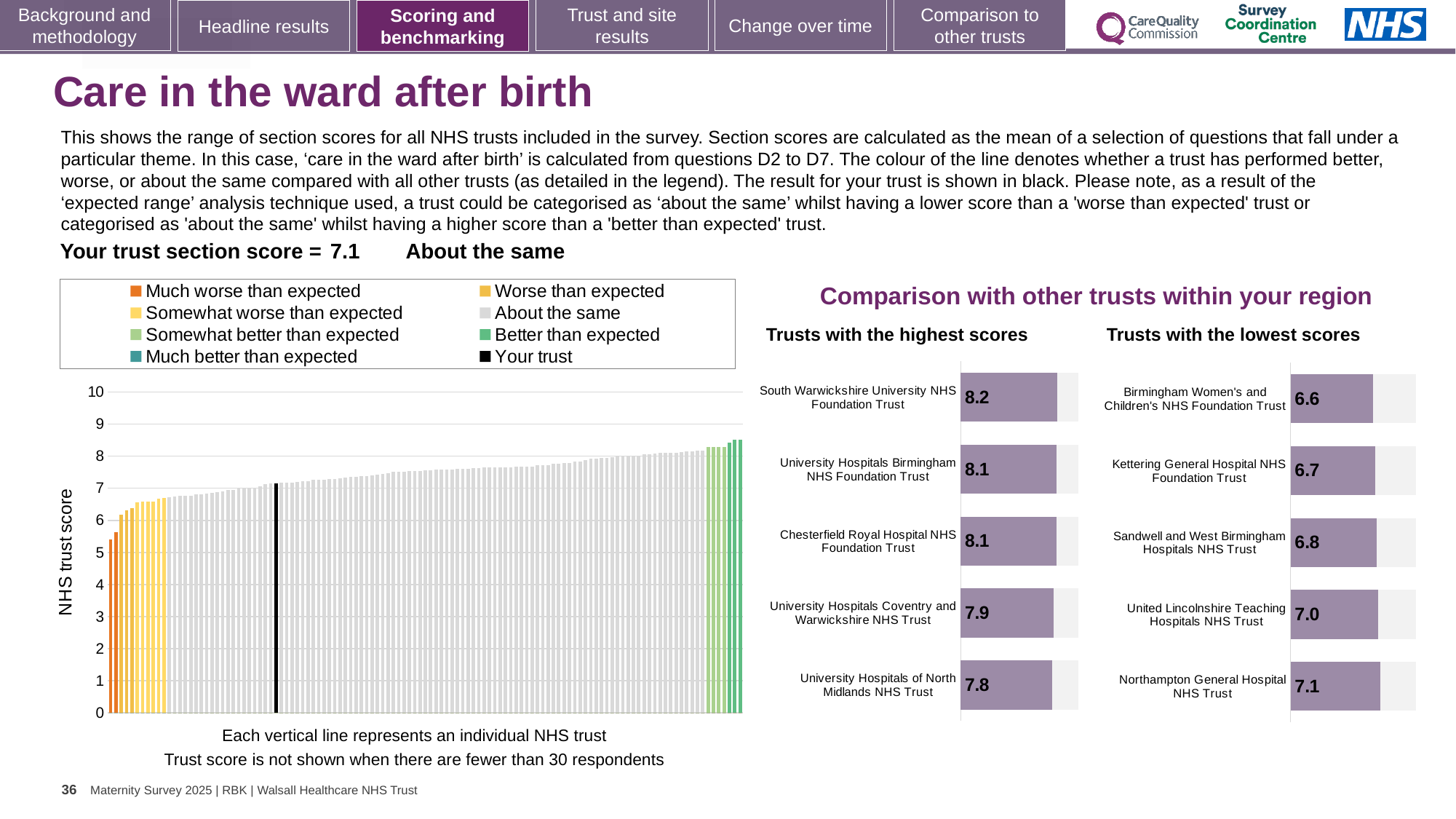
In the 'Trusts with the highest scores' chart, what is the score for South Warwickshire University NHS Foundation Trust? 8.2 In the main chart on the left, is the value of the black 'Your trust' bar greater or less than 5? greater How many trusts are shown in the 'Trusts with the highest scores' chart? 5 What kind of chart is the main chart on the left of the slide? bar chart In the 'Trusts with the lowest scores' chart, what is the difference between the scores of Northampton General Hospital NHS Trust and Birmingham Women's and Children's NHS Foundation Trust? 0.5 In the main chart on the left, is the value of the tallest bar greater or less than 8? greater In the 'Trusts with the lowest scores' chart, which trust has the lowest score? Birmingham Women's and Children's NHS Foundation Trust In the 'Trusts with the highest scores' chart, what is the difference between the scores of South Warwickshire University NHS Foundation Trust and University Hospitals of North Midlands NHS Trust? 0.4 In the 'Trusts with the lowest scores' chart, which has the higher score: Kettering General Hospital NHS Foundation Trust or Sandwell and West Birmingham Hospitals NHS Trust? Sandwell and West Birmingham Hospitals NHS Trust In the 'Trusts with the highest scores' chart, what is the score for University Hospitals of North Midlands NHS Trust? 7.8 In the 'Trusts with the lowest scores' chart, what is the score for Kettering General Hospital NHS Foundation Trust? 6.7 In the 'Trusts with the lowest scores' chart, which trust has the highest score? Northampton General Hospital NHS Trust